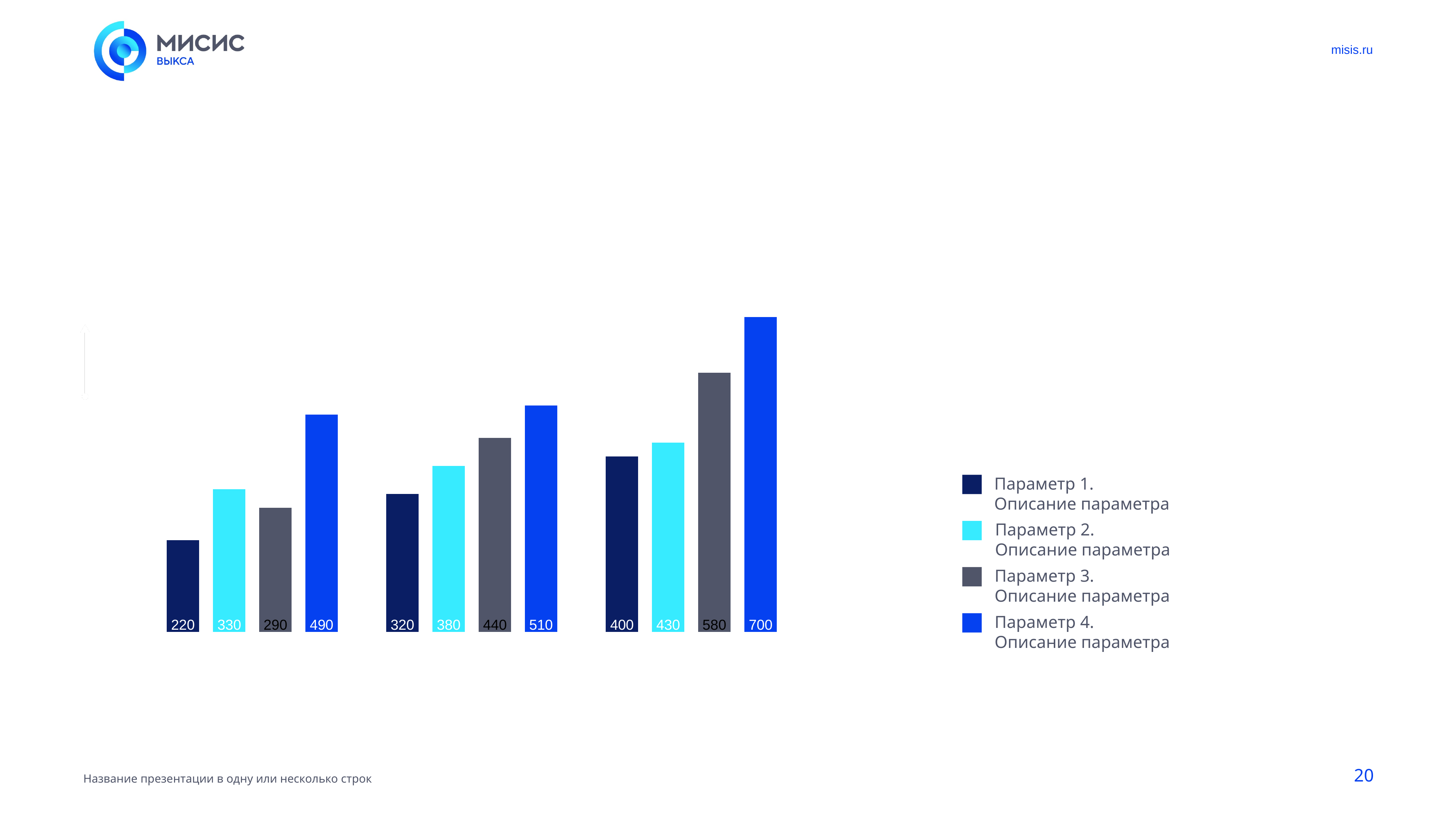
Which series has the highest bar in the rightmost group of bars? Параметр 4 What is the value of the Параметр 3 bar in the middle group of bars? 440 In the leftmost group of bars, which is larger: the Параметр 2 bar or the Параметр 3 bar? Параметр 2 What kind of chart is shown on the slide? bar chart Do the Параметр 4 values rise or fall from the leftmost group to the rightmost group? rise Which series has the lowest bar in the leftmost group of bars? Параметр 1 How many series does the legend list? 4 How many groups of bars are plotted in the chart? 3 What is the difference between the Параметр 4 and Параметр 1 bars in the rightmost group of bars? 300 What is the value of the Параметр 4 bar in the rightmost group of bars? 700 What colour is used for Параметр 2 in the legend? cyan What is the value of the Параметр 1 bar in the leftmost group of bars? 220